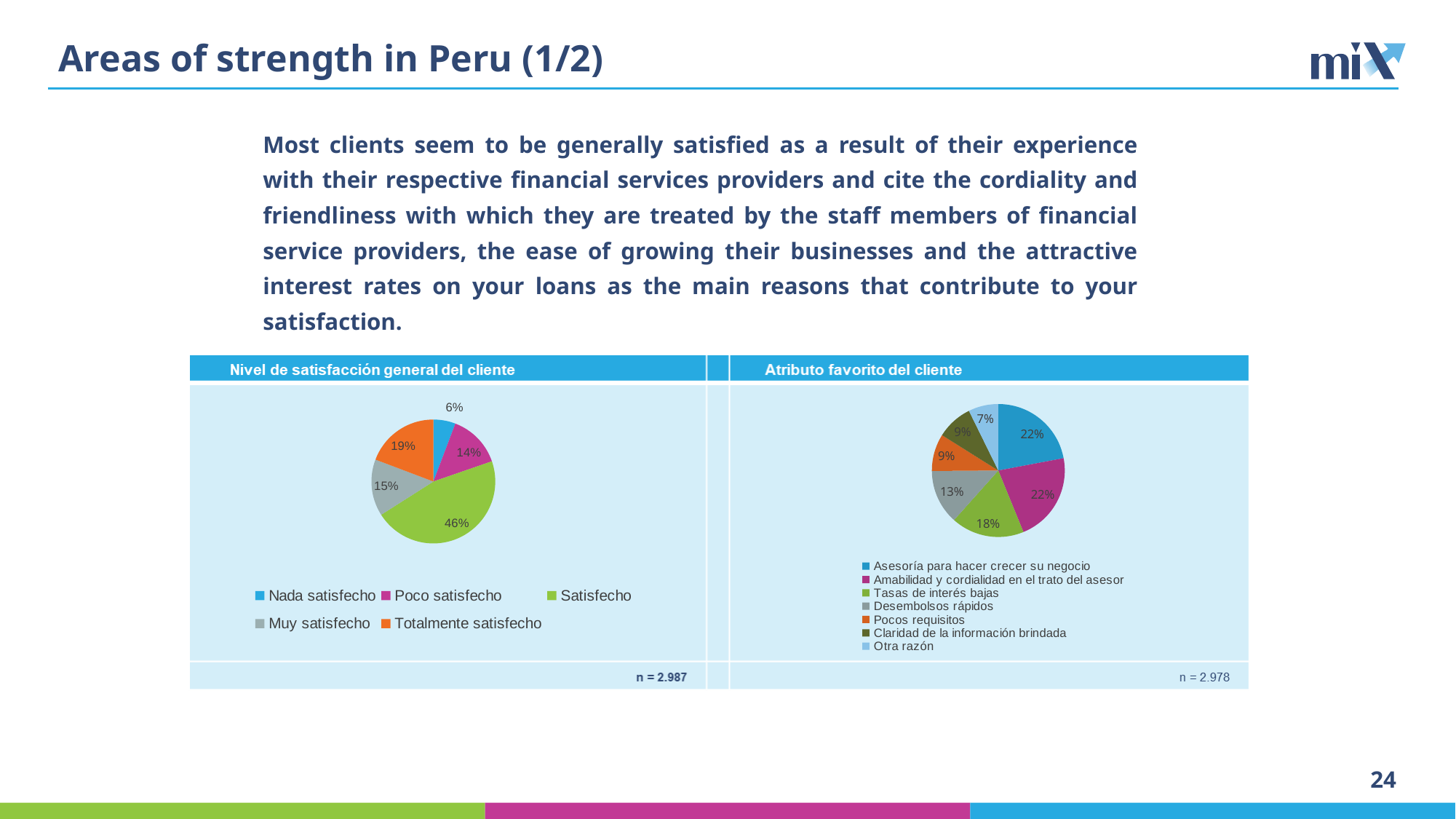
In the 'Nivel de satisfacción general del cliente' chart, how many categories are shown? 5 In the 'Nivel de satisfacción general del cliente' chart, what is the difference between 'Totalmente satisfecho' and 'Muy satisfecho'? 4% In the 'Nivel de satisfacción general del cliente' chart, which category has the largest slice? Satisfecho In the 'Atributo favorito del cliente' chart, which category has the smallest slice? Otra razón How many categories does the legend of the 'Atributo favorito del cliente' chart list? 7 What type of chart is used for 'Atributo favorito del cliente'? Pie chart In the 'Atributo favorito del cliente' chart, what share is 'Desembolsos rápidos'? 13% In the 'Atributo favorito del cliente' chart, which is larger: 'Tasas de interés bajas' or 'Pocos requisitos'? Tasas de interés bajas In the 'Nivel de satisfacción general del cliente' chart, what share of clients are 'Satisfecho'? 46% In the 'Nivel de satisfacción general del cliente' chart, what percentage is 'Nada satisfecho'? 6% In the 'Atributo favorito del cliente' chart, what percentage is 'Tasas de interés bajas'? 18% In the 'Nivel de satisfacción general del cliente' chart, which category has the smallest slice? Nada satisfecho